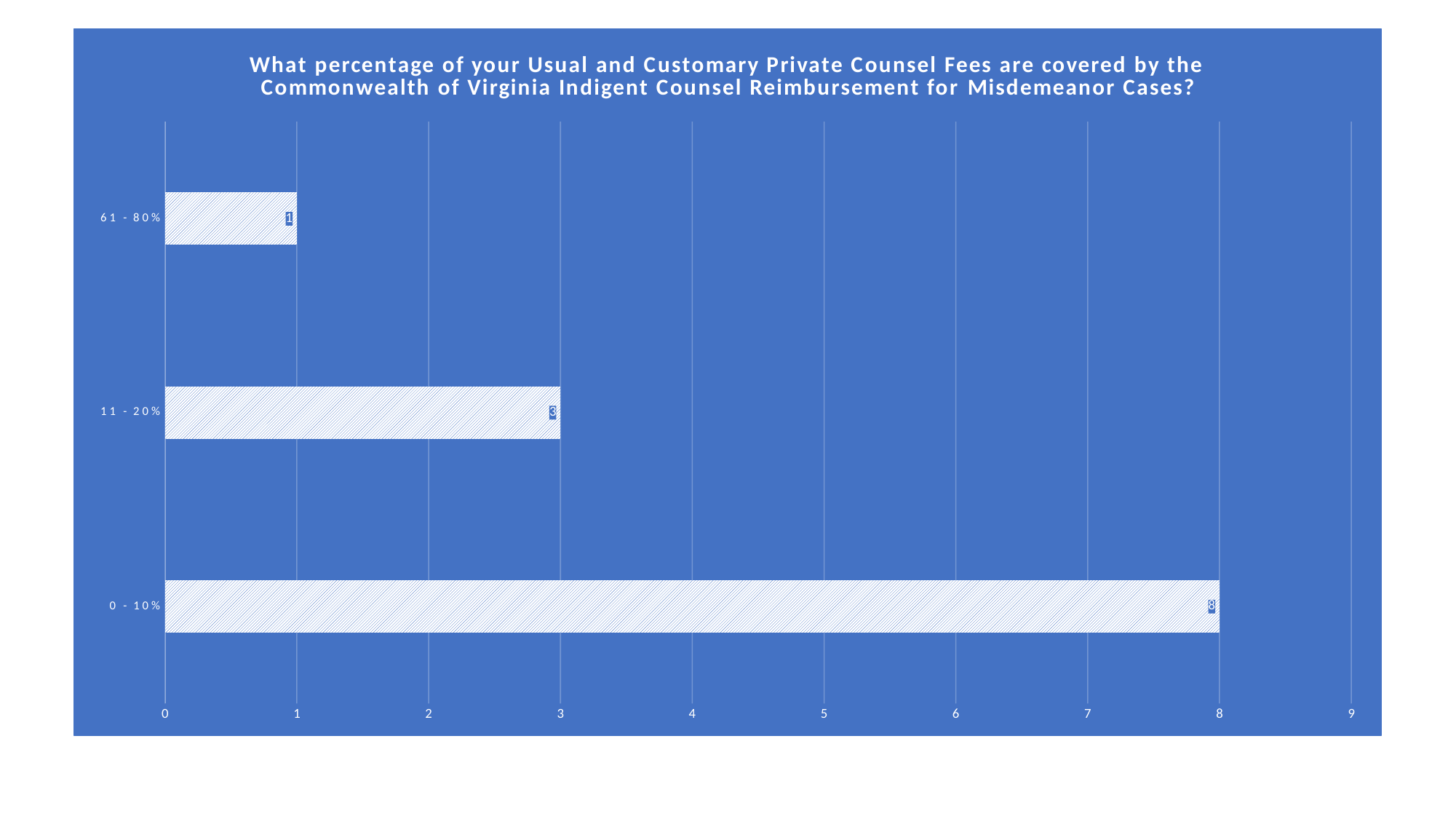
What is the value for the 61 - 80% category? 1 Is the value for 0 - 10% greater or less than 5? greater What is the difference between the values for 0 - 10% and 11 - 20%? 5 Which is larger, the value for 11 - 20% or the value for 61 - 80%? 11 - 20% Which category has the highest value? 0 - 10% What is the value for the 0 - 10% category? 8 What kind of chart is shown on the slide? bar chart Which category has the lowest value? 61 - 80% How many categories are shown in the chart? 3 What is the difference between the values for 11 - 20% and 61 - 80%? 2 What is the value for the 11 - 20% category? 3 What is the highest value shown on the horizontal axis? 9